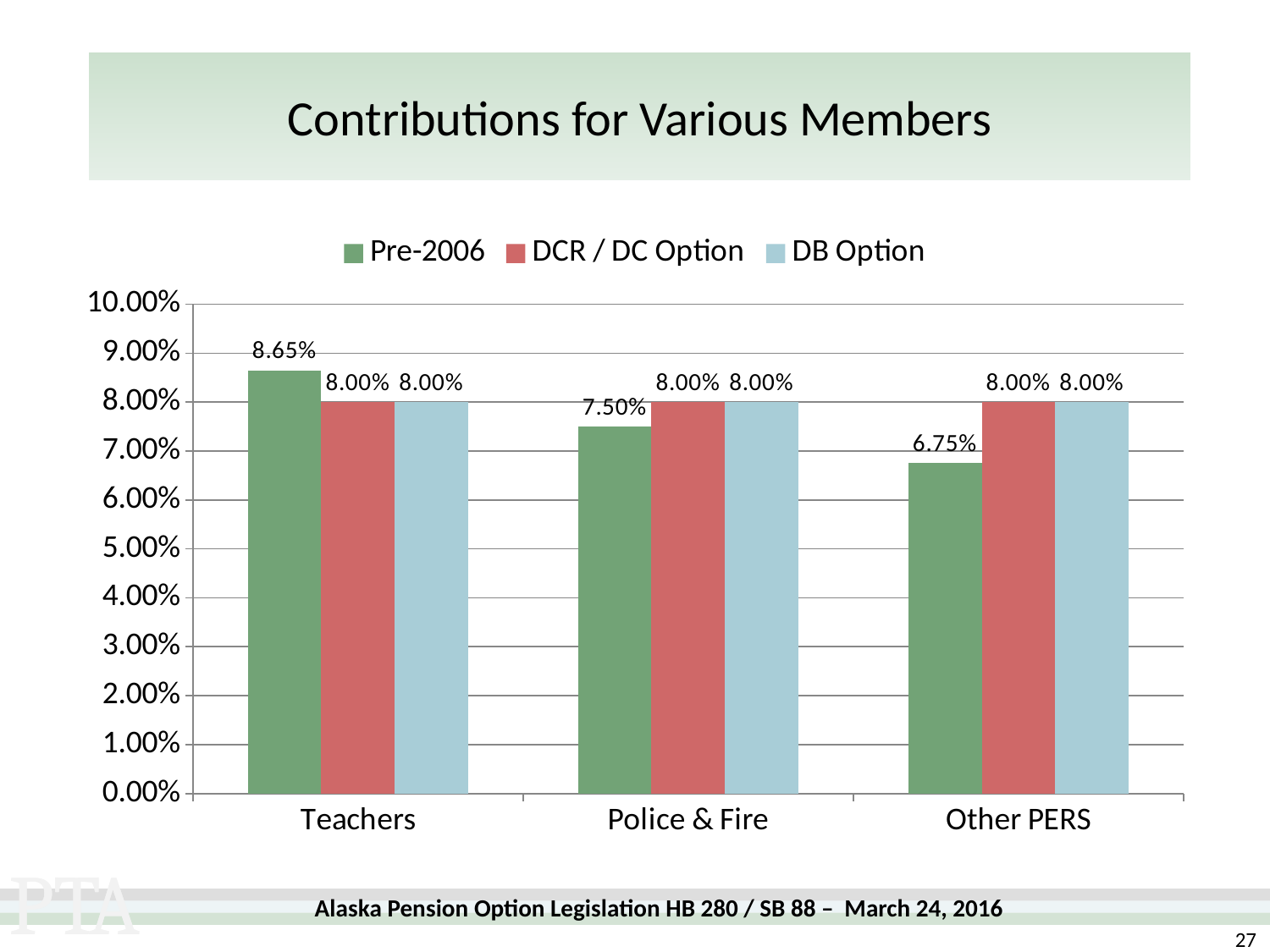
What is the Pre-2006 contribution rate for Teachers? 8.65% Which is larger for Teachers: the Pre-2006 rate or the DB Option rate? Pre-2006 Is the Pre-2006 value for Other PERS greater or less than 7.00%? less What is the difference between the Pre-2006 rate for Teachers and the Pre-2006 rate for Other PERS? 1.90% What is the difference between the Pre-2006 rate and the DB Option rate for Police & Fire? 0.50% Which member group has the highest Pre-2006 contribution rate? Teachers Which member group has the lowest Pre-2006 contribution rate? Other PERS What is the Pre-2006 contribution rate for Other PERS? 6.75% How many series does the legend list? 3 What is the DCR / DC Option contribution rate for Police & Fire? 8.00% How many member groups are shown on the x axis? 3 What kind of chart is shown on the slide? Bar chart